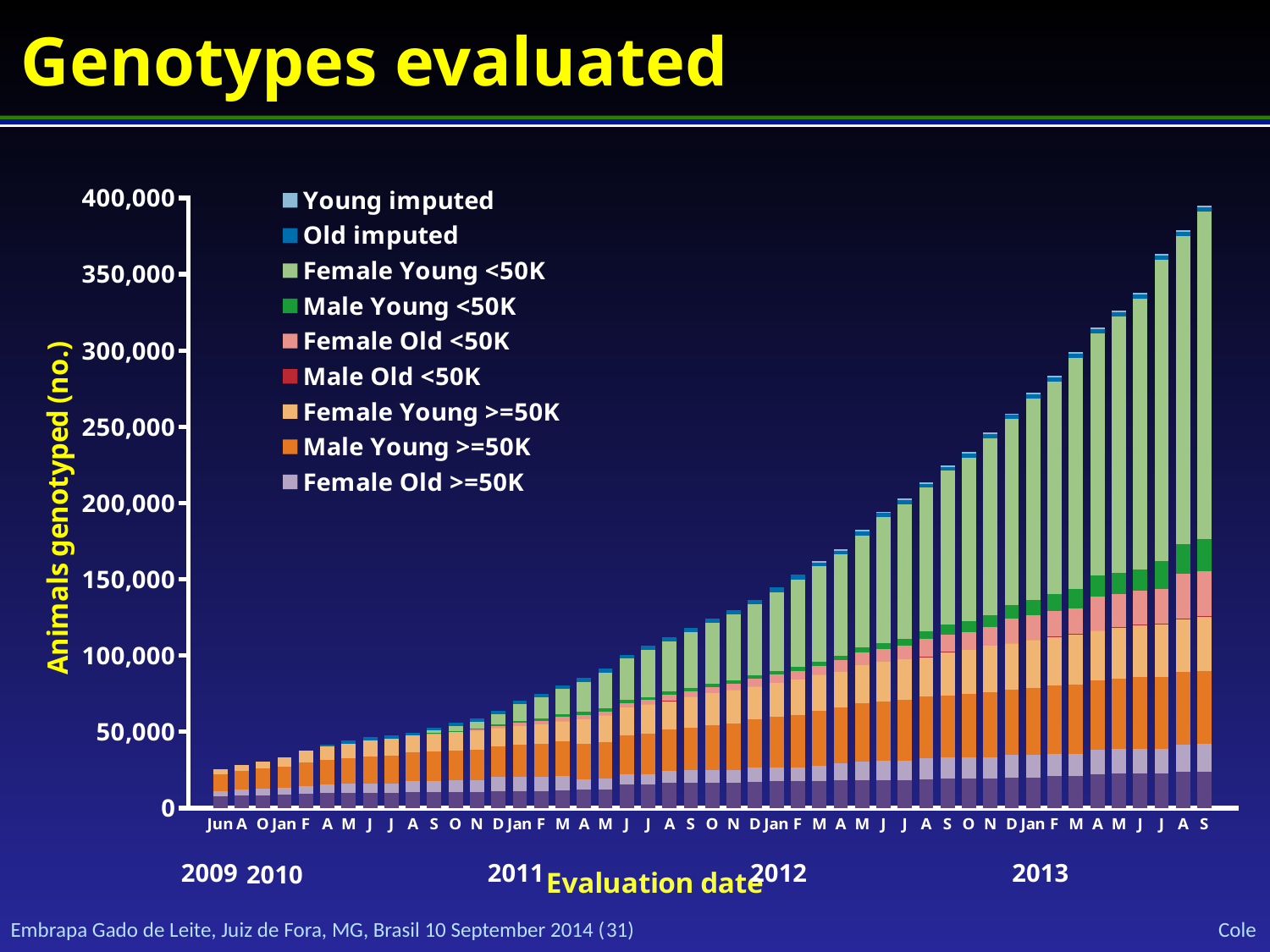
Is the total for the last bar (S 2013) greater or less than 350,000? greater Which series is listed first in the legend? Young imputed Is the total for the first bar (Jun 2009) greater or less than 50,000? less Do the total animals genotyped rise or fall along the x axis from 2009 to 2013? rise Which evaluation date has the highest total of animals genotyped? S 2013 (September 2013) What is the label of the y axis? Animals genotyped (no.) Is the total for Jan 2011 greater or less than 100,000? less What kind of chart is shown on the slide? stacked bar chart How many series does the legend list? 9 Which evaluation date has the lowest total of animals genotyped? Jun 2009 Which is larger, the total for Jan 2012 or the total for Jan 2013? Jan 2013